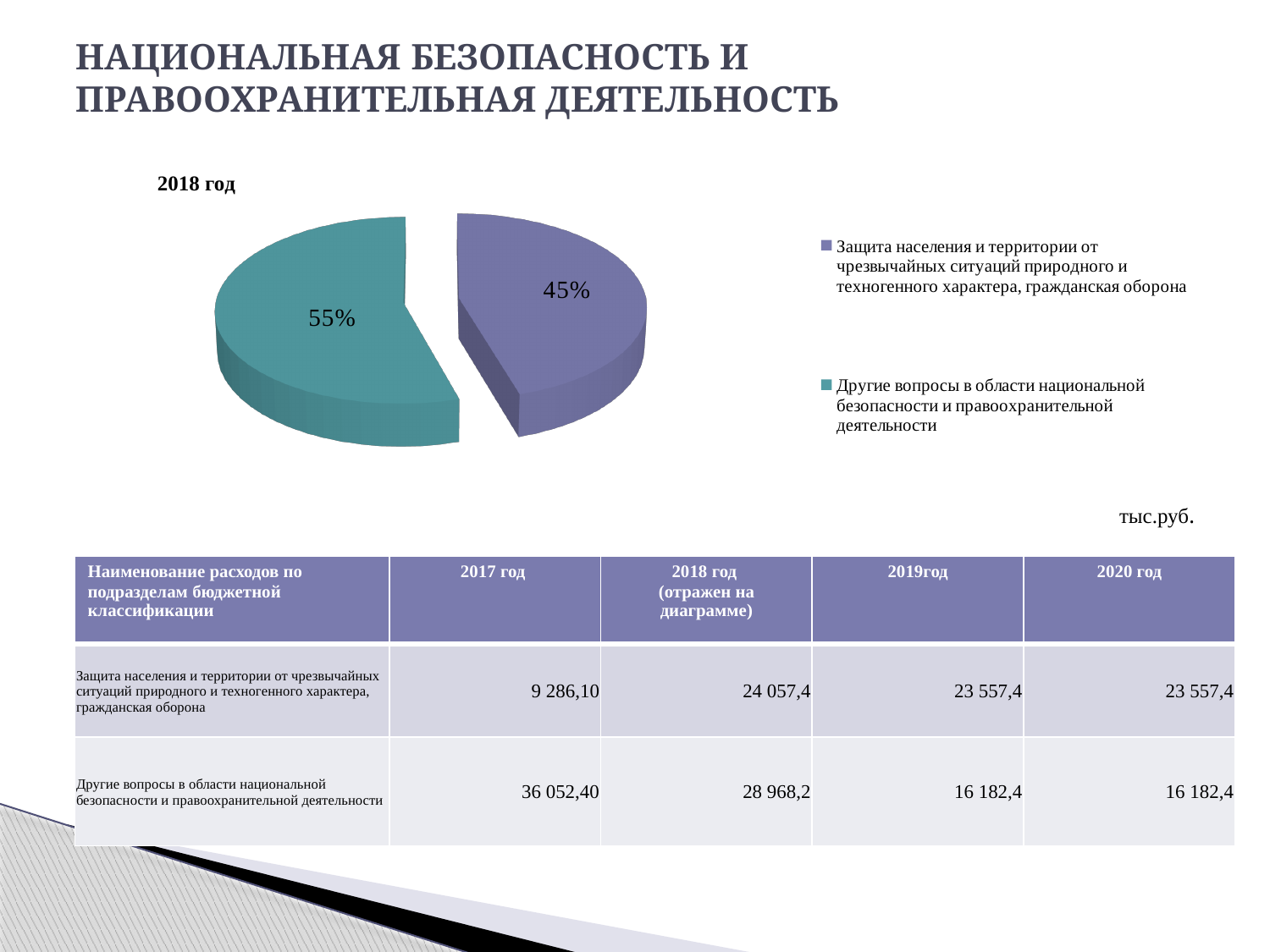
How many entries does the legend of the pie chart list? 2 Which category has the largest slice in the pie chart? Другие вопросы в области национальной безопасности и правоохранительной деятельности What is the title of the pie chart? 2018 год What kind of chart is shown on the slide? pie chart Which category has the smallest slice in the pie chart? Защита населения и территории от чрезвычайных ситуаций природного и техногенного характера, гражданская оборона By how many percentage points does the "Другие вопросы..." slice exceed the "Защита населения..." slice? 10 Which slice is larger: "Защита населения и территории от чрезвычайных ситуаций..." or "Другие вопросы в области национальной безопасности..."? Другие вопросы в области национальной безопасности и правоохранительной деятельности How many slices does the pie chart have? 2 What colour is the slice for "Другие вопросы в области национальной безопасности и правоохранительной деятельности"? teal (green) What share of the pie does "Защита населения и территории от чрезвычайных ситуаций природного и техногенного характера, гражданская оборона" have? 45% What share of the pie does "Другие вопросы в области национальной безопасности и правоохранительной деятельности" have? 55%